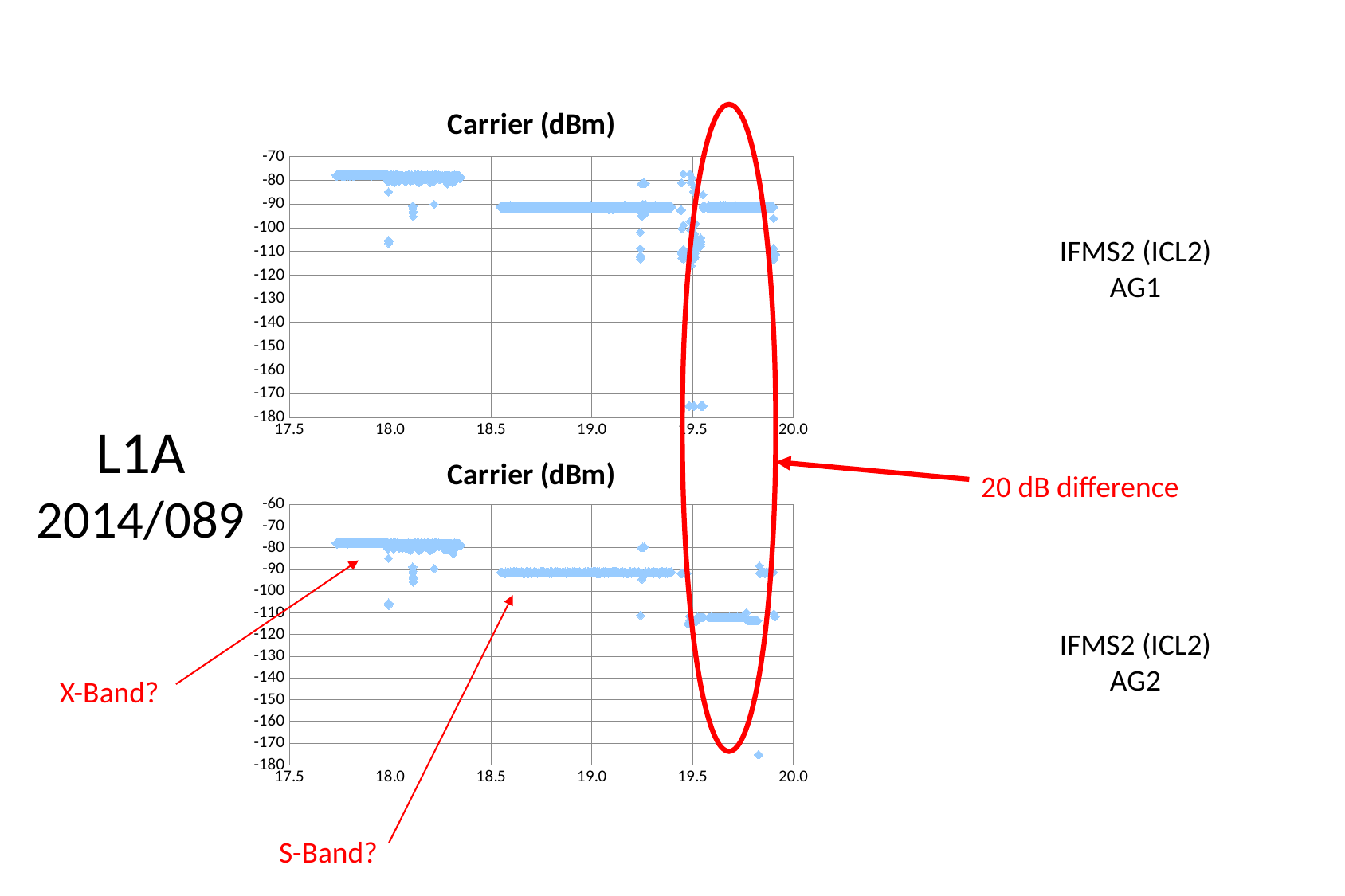
What is the title of the top chart? Carrier (dBm) What kind of chart is the top chart on the slide? scatter chart In the bottom chart, is the value at x = 19.7 greater or less than -100? less In the bottom chart, do the plotted values generally rise or fall as x increases from 17.7 to 19.7? fall In the top chart, is the value at x = 17.8 greater or less than -90? greater In the top chart, do the plotted values rise or fall from x = 17.8 to x = 18.8? fall How many charts are shown on the slide? 2 In the top chart, is the value at x = 18.8 greater or less than -80? less In the top chart, what is the highest value shown on the y axis? -70 In the bottom chart, which is higher: the value at x = 17.8 or the value at x = 19.7? x = 17.8 In the bottom chart, what is the highest value shown on the y axis? -60